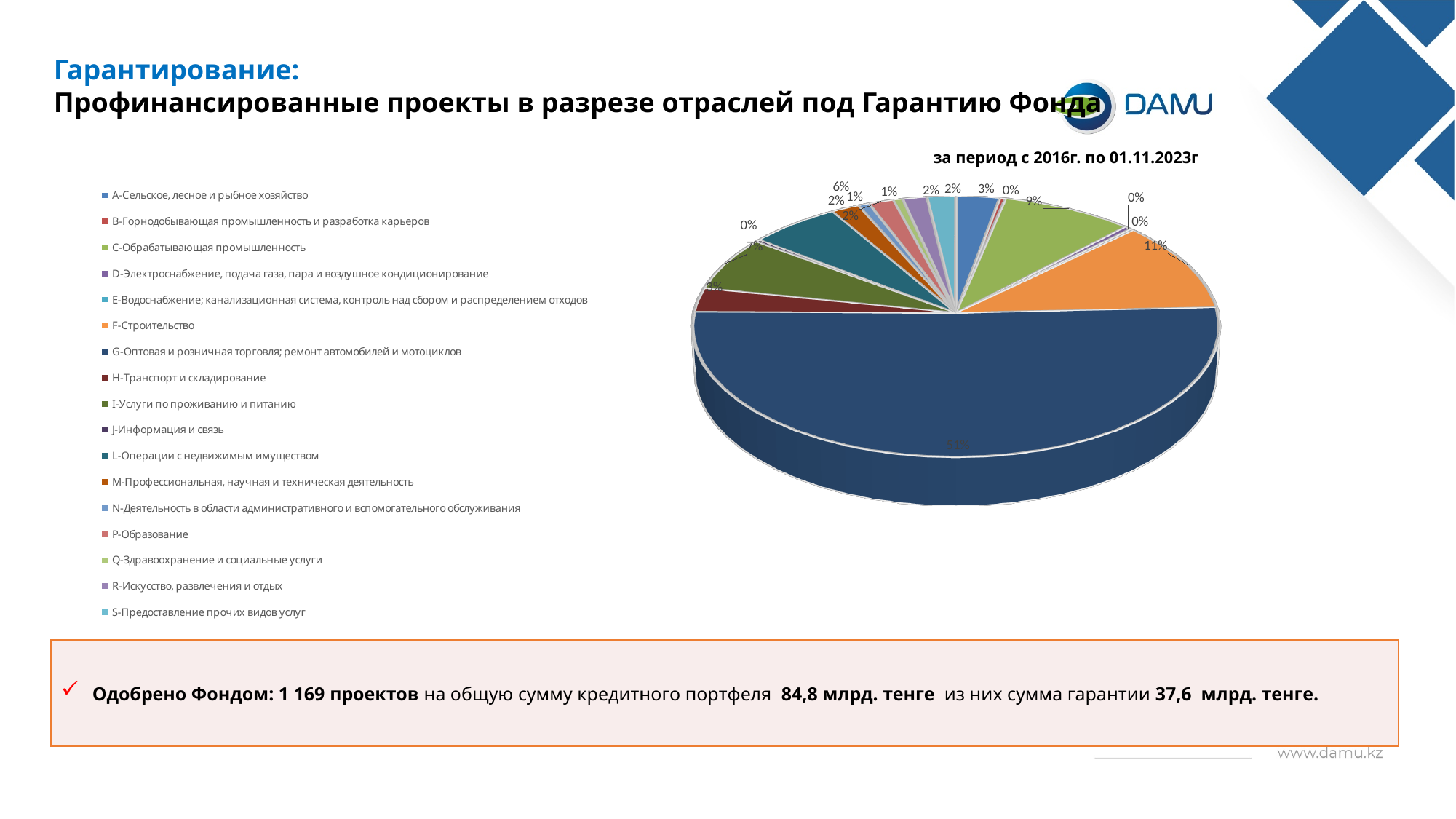
What colour is the slice for F-Строительство? orange What is the difference in percentage points between the shares of F-Строительство and C-Обрабатывающая промышленность? 2% What share of the pie does G-Оптовая и розничная торговля; ремонт автомобилей и мотоциклов have? 51% What period does the pie chart cover, according to the label above it? за период с 2016г. по 01.11.2023г What share of the pie does I-Услуги по проживанию и питанию have? 7% Which category has the largest slice of the pie chart? G-Оптовая и розничная торговля; ремонт автомобилей и мотоциклов How many categories does the legend of the pie chart list? 17 What share of the pie does C-Обрабатывающая промышленность have? 9% What share of the pie does H-Транспорт и складирование have? 3% What kind of chart is shown on the slide? pie chart Which is larger, the share for F-Строительство or for C-Обрабатывающая промышленность? F-Строительство What share of the pie does F-Строительство have? 11%